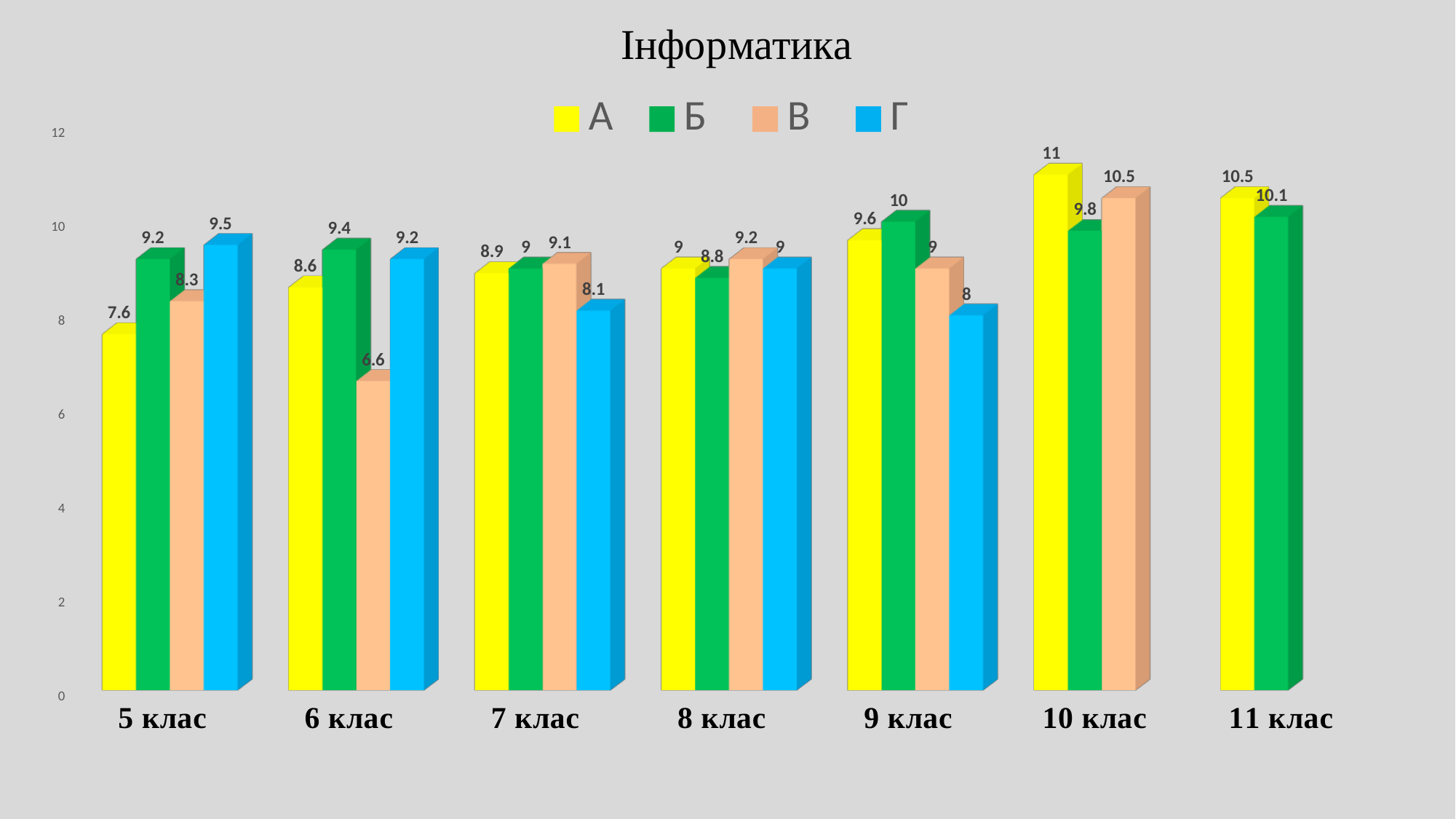
What kind of chart is shown? bar chart Which is larger in 8 клас: series В or series Г? В How many series does the legend list? 4 What is the title of the chart? Інформатика What is the value for series Г in 9 клас? 8 How many classes (categories) are shown on the x axis? 7 Which class has the highest value for series А? 10 клас What is the difference between series А and series Б in 10 клас? 1.2 What is the value for series Б in 11 клас? 10.1 What is the value for series В in 6 клас? 6.6 Which class has the lowest value for series В? 6 клас What is the value for series А in 5 клас? 7.6